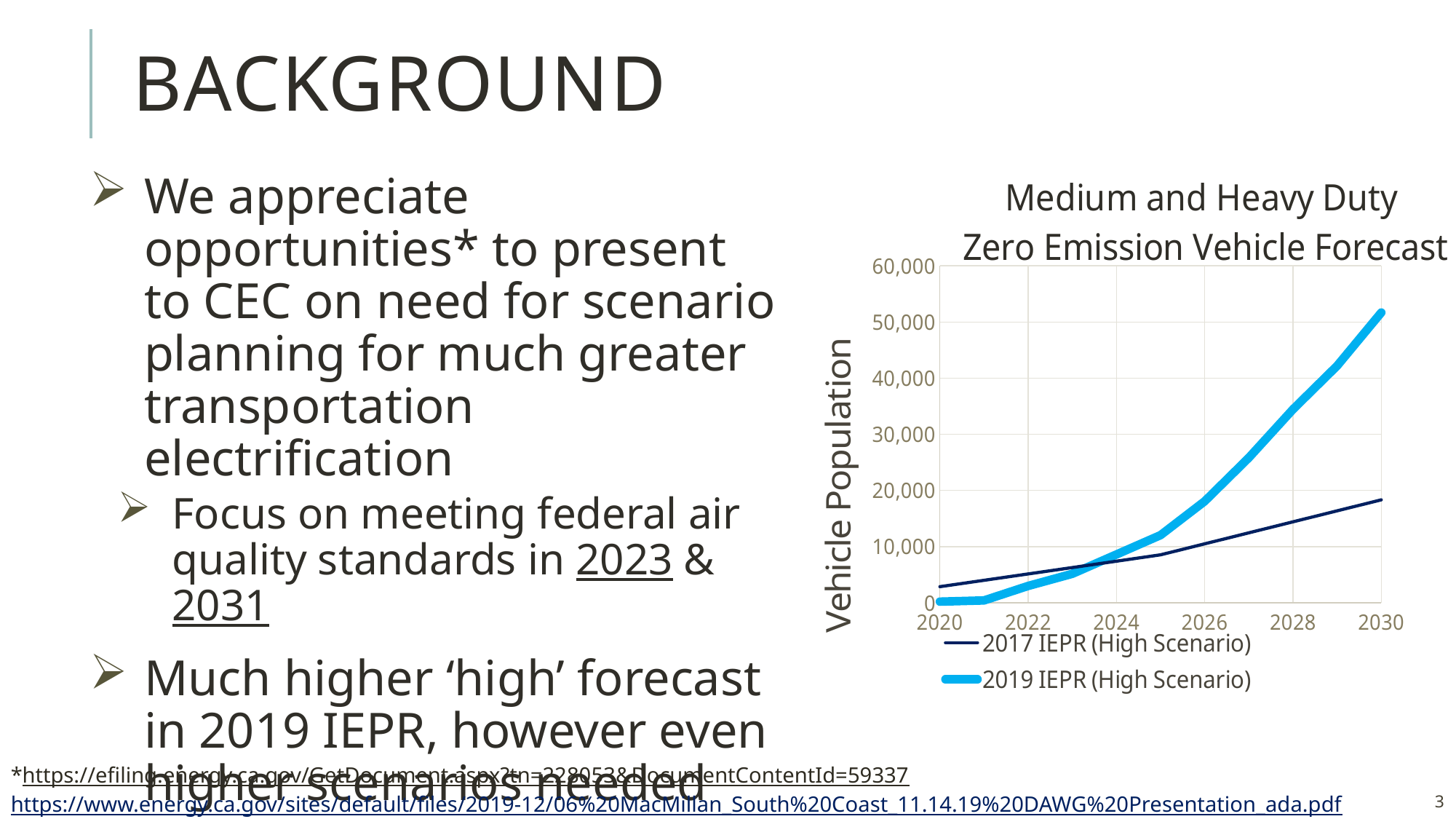
Does the 2019 IEPR (High Scenario) line rise or fall from 2020 to 2030? rise What is the title of the chart? Medium and Heavy Duty Zero Emission Vehicle Forecast Is the value for 2019 IEPR (High Scenario) in 2026 greater or less than 20,000? less Is the value for 2017 IEPR (High Scenario) in 2030 greater or less than 20,000? less What kind of chart is shown on the slide? line chart What is the label on the vertical axis of the chart? Vehicle Population In 2020, which series has the higher vehicle population, 2017 IEPR (High Scenario) or 2019 IEPR (High Scenario)? 2017 IEPR (High Scenario) How many series does the chart legend list? 2 Is the value for 2019 IEPR (High Scenario) in 2030 greater or less than 40,000? greater In 2030, which series has the higher vehicle population, 2017 IEPR (High Scenario) or 2019 IEPR (High Scenario)? 2019 IEPR (High Scenario) Does the 2017 IEPR (High Scenario) line rise or fall from 2020 to 2030? rise